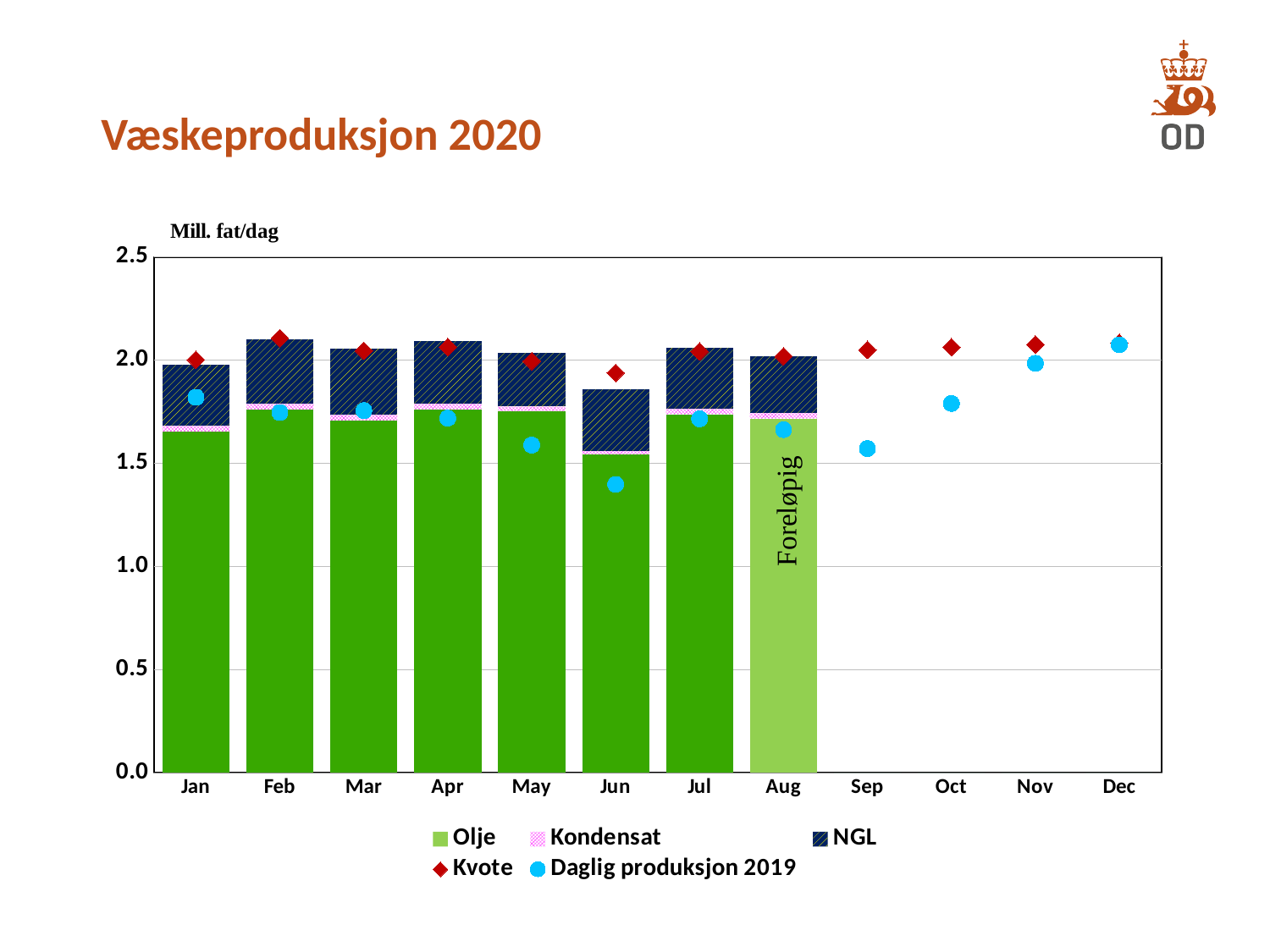
Do the Daglig produksjon 2019 values rise or fall from Sep to Dec? rise What kind of chart is shown on the slide? Stacked bar chart with point markers How many months have a stacked bar plotted? 8 Which month has the lowest total stacked bar? Jun In which month is the Daglig produksjon 2019 marker lowest? Jun Is the total stacked bar for Jun greater or less than 2.0? less In which month is the Daglig produksjon 2019 marker highest? Dec How many series does the legend list? 5 Which is larger in Jun, the Kvote marker or the Daglig produksjon 2019 marker? Kvote Is the Daglig produksjon 2019 value for Jun greater or less than 1.5? less How many months are shown on the x axis? 12 What unit label is shown above the y axis? Mill. fat/dag